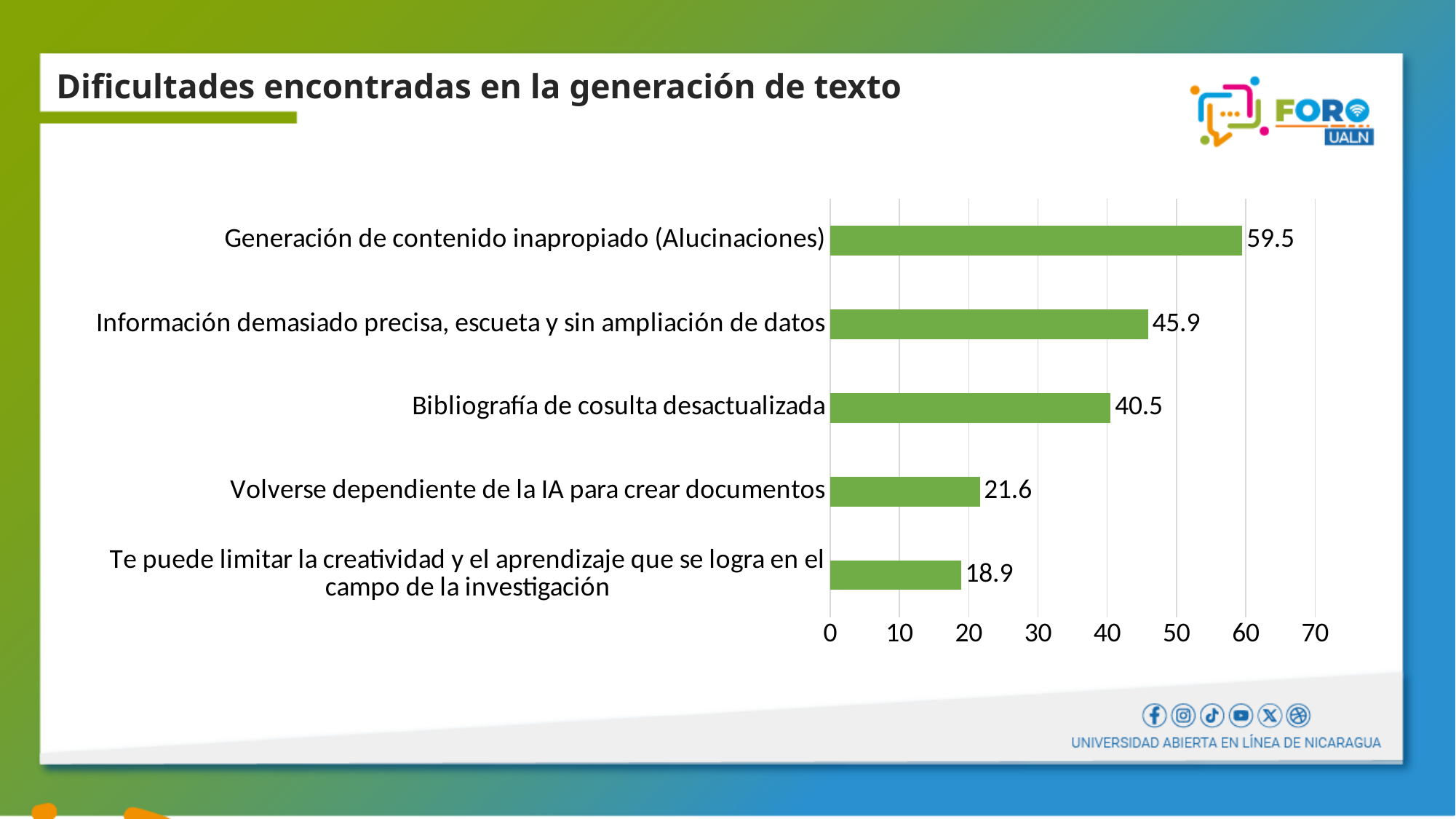
What is the difference between the values for "Volverse dependiente de la IA para crear documentos" and "Te puede limitar la creatividad y el aprendizaje que se logra en el campo de la investigación"? 2.7 Is the value for "Bibliografía de cosulta desactualizada" greater or less than 30? greater What kind of chart is shown on the slide? Bar chart Which category has the highest value? Generación de contenido inapropiado (Alucinaciones) What is the value for "Bibliografía de cosulta desactualizada"? 40.5 What is the value for "Generación de contenido inapropiado (Alucinaciones)"? 59.5 What is the value for "Volverse dependiente de la IA para crear documentos"? 21.6 Which category has the lowest value? Te puede limitar la creatividad y el aprendizaje que se logra en el campo de la investigación What is the title of the slide containing the chart? Dificultades encontradas en la generación de texto How many categories are shown in the chart? 5 Which is larger: the value for "Información demasiado precisa, escueta y sin ampliación de datos" or for "Bibliografía de cosulta desactualizada"? Información demasiado precisa, escueta y sin ampliación de datos What is the difference between the values for "Generación de contenido inapropiado (Alucinaciones)" and "Información demasiado precisa, escueta y sin ampliación de datos"? 13.6